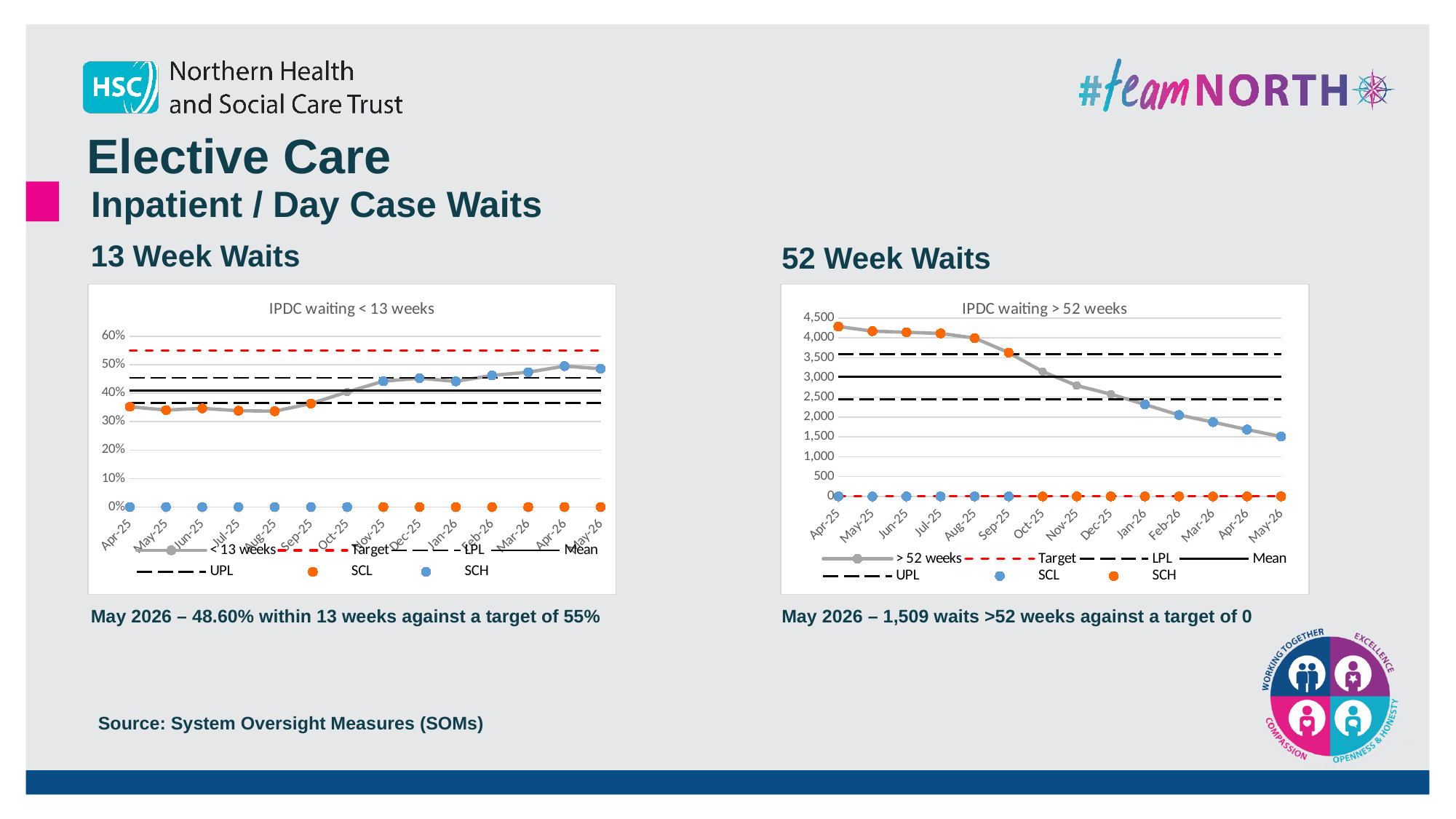
On the 'IPDC waiting > 52 weeks' chart, do the values rise or fall from Apr-25 to May-26? fall On the 'IPDC waiting > 52 weeks' chart, which month has the lowest number of waits? May-26 On the 'IPDC waiting < 13 weeks' chart, do the values generally rise or fall from Apr-25 to May-26? rise On the 'IPDC waiting < 13 weeks' chart, what is the target value? 55% On the 'IPDC waiting > 52 weeks' chart, what is the target value? 0 On the 'IPDC waiting < 13 weeks' chart, what is the value for May-26? 48.60% On the 'IPDC waiting > 52 weeks' chart, is the value for Apr-25 greater or less than 4,000? greater On the 'IPDC waiting < 13 weeks' chart, is the value for Apr-25 greater or less than 40%? less On the 'IPDC waiting > 52 weeks' chart, which month has the highest number of waits? Apr-25 How many months are plotted on the 'IPDC waiting < 13 weeks' chart? 14 On the 'IPDC waiting > 52 weeks' chart, what is the value for May-26? 1,509 On the 'IPDC waiting > 52 weeks' chart, is the value for Jan-26 greater or less than 2,500? less